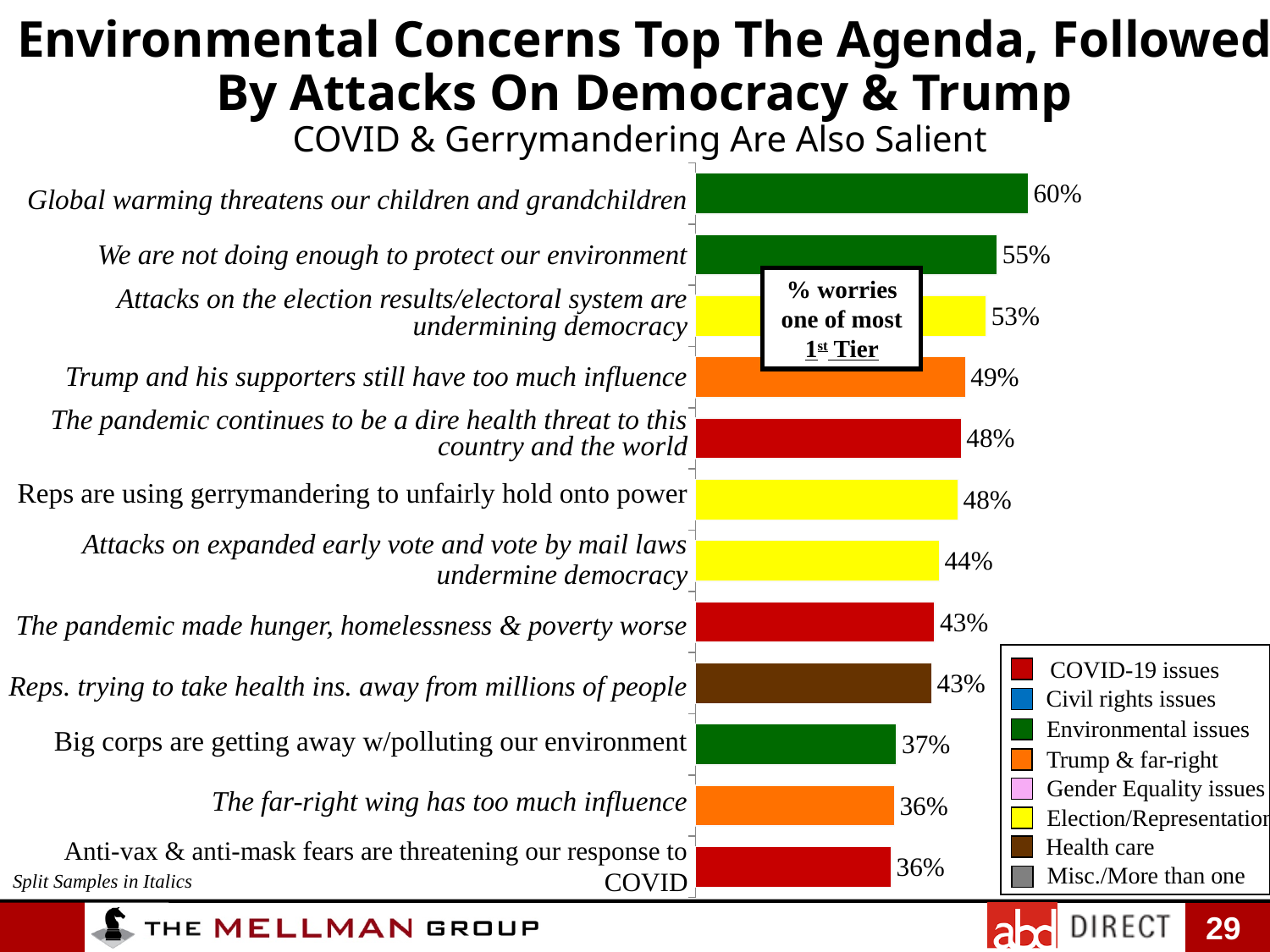
According to the legend, what colour represents Environmental issues? Green What percentage worries about "Global warming threatens our children and grandchildren"? 60% What percentage is shown for "Reps are using gerrymandering to unfairly hold onto power"? 48% What is the value for "Big corps are getting away w/polluting our environment"? 37% What is the value for "Trump and his supporters still have too much influence"? 49% What is the difference between "Global warming threatens our children and grandchildren" and "We are not doing enough to protect our environment"? 5% How many entries does the legend list? 8 What is the lowest percentage shown on the chart? 36% How many bars are plotted on the chart? 12 Which is larger: "Attacks on the election results/electoral system are undermining democracy" or "Attacks on expanded early vote and vote by mail laws undermine democracy"? Attacks on the election results/electoral system are undermining democracy What kind of chart is shown on the slide? Bar chart Which item has the highest percentage? Global warming threatens our children and grandchildren